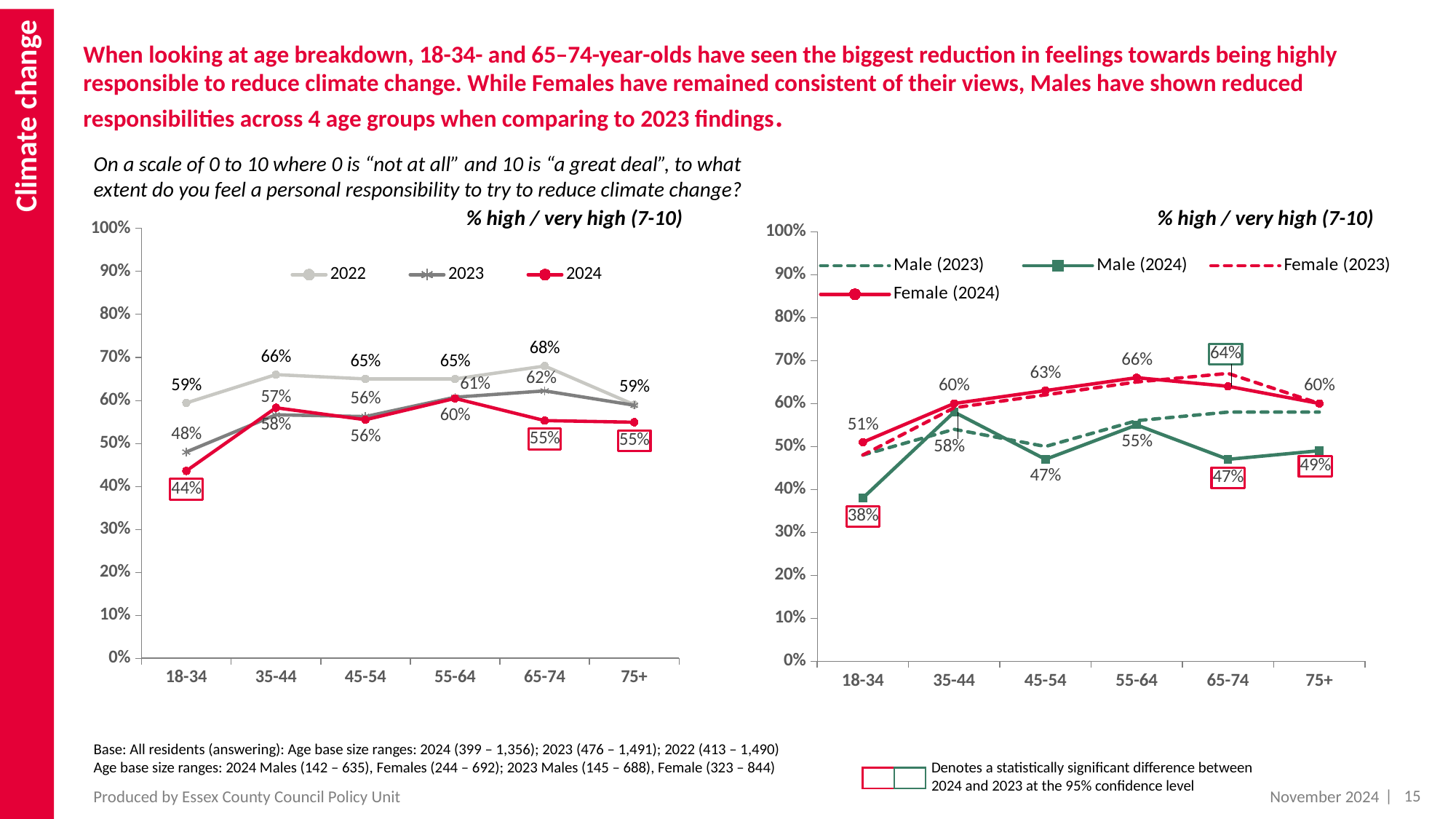
In the left chart, what is the difference between the 2022 and 2024 values for the 18-34 age group? 15 percentage points In the left chart, what is the 2024 value for the 18-34 age group? 44% How many series does the legend of the left chart list? 3 In the right chart, what is the difference between the Female (2024) and Male (2024) values for the 45-54 age group? 16 percentage points In the left chart, what is the 2022 value for the 65-74 age group? 68% In the left chart, which age group has the lowest 2024 value? 18-34 In the left chart, which age group has the highest 2022 value? 65-74 In the right chart, is the Male (2024) value higher for the 35-44 or the 45-54 age group? 35-44 How many series does the legend of the right chart list? 4 In the right chart, what is the Female (2024) value for the 55-64 age group? 66% In the right chart, what is the Male (2024) value for the 18-34 age group? 38% What kind of chart is the left chart? Line chart